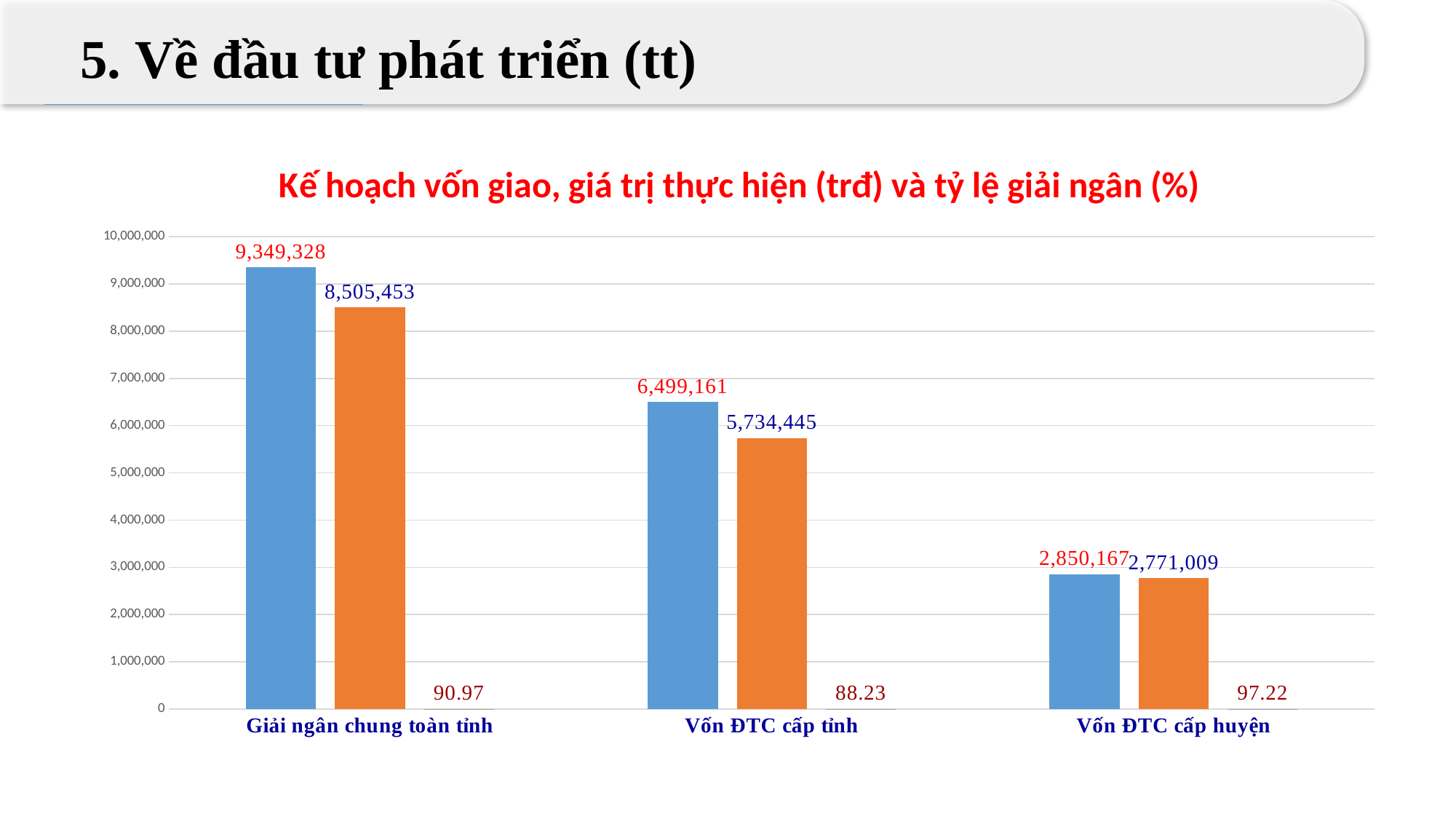
What is the value of the orange bar for "Giải ngân chung toàn tỉnh"? 8,505,453 Which category has the highest blue bar? Giải ngân chung toàn tỉnh How many categories are shown on the x axis? 3 What disbursement rate (%) is shown for "Vốn ĐTC cấp huyện"? 97.22 What is the difference between the blue bar and the orange bar for "Vốn ĐTC cấp tỉnh"? 764,716 What is the value of the blue bar for "Giải ngân chung toàn tỉnh"? 9,349,328 Which category has the highest disbursement rate (%) label? Vốn ĐTC cấp huyện Which is larger for "Vốn ĐTC cấp huyện": the blue bar or the orange bar? the blue bar What kind of chart is shown on the slide? bar chart What is the value of the orange bar for "Vốn ĐTC cấp tỉnh"? 5,734,445 What is the title of the chart? Kế hoạch vốn giao, giá trị thực hiện (trđ) và tỷ lệ giải ngân (%) Which category has the lowest orange bar? Vốn ĐTC cấp huyện